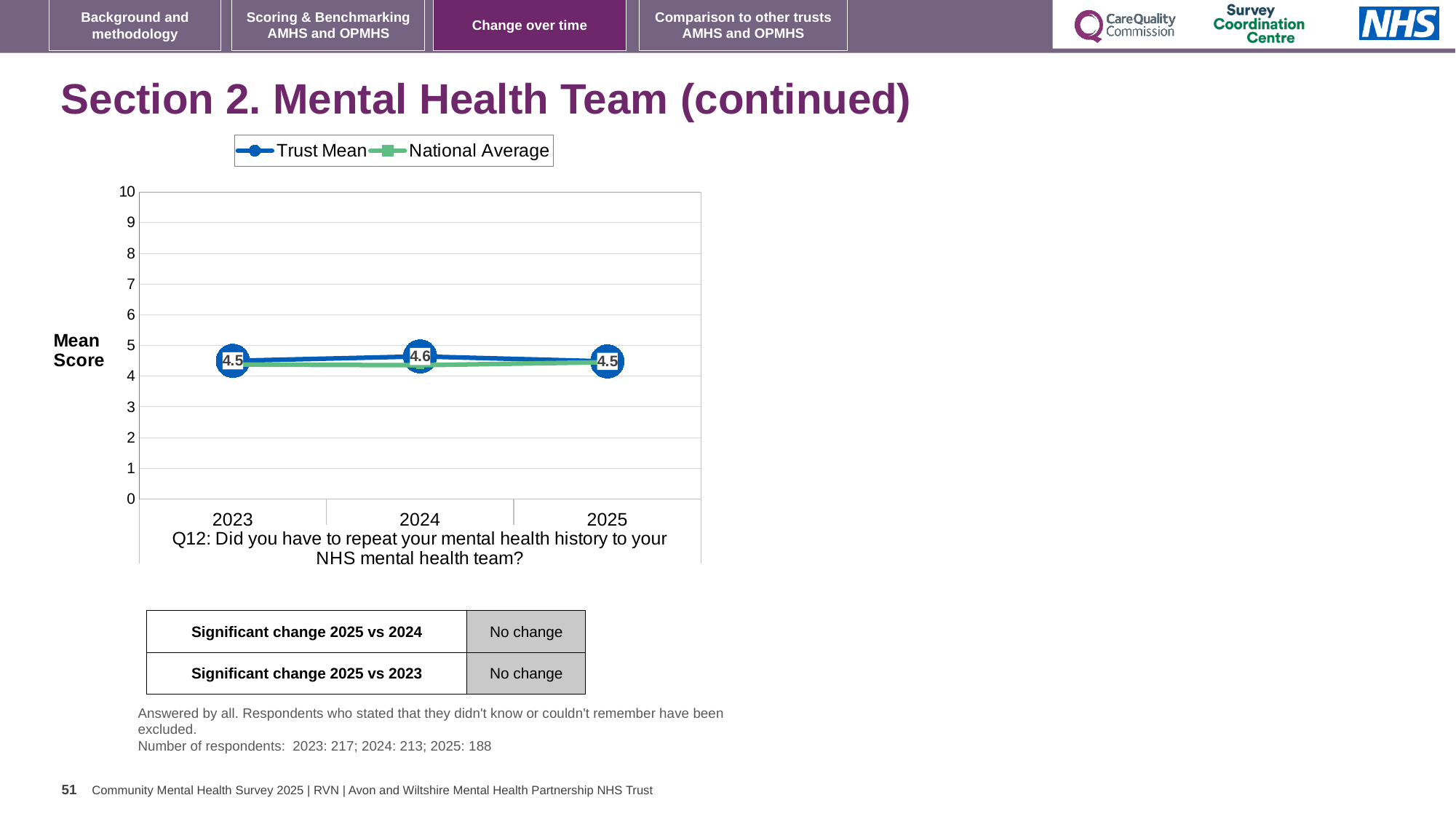
What is the Trust Mean score for 2024? 4.6 What kind of chart is shown? line chart How many series does the legend list? 2 What is the label on the y axis? Mean Score What is the Trust Mean score for 2025? 4.5 Is the Trust Mean for 2024 greater or less than 5? less What are the two series named in the legend? Trust Mean and National Average How many years are shown on the x axis? 3 What is the Trust Mean score for 2023? 4.5 Is the National Average for 2023 greater or less than 5? less In which year is the Trust Mean highest? 2024 What is the difference between the Trust Mean in 2024 and in 2023? 0.1